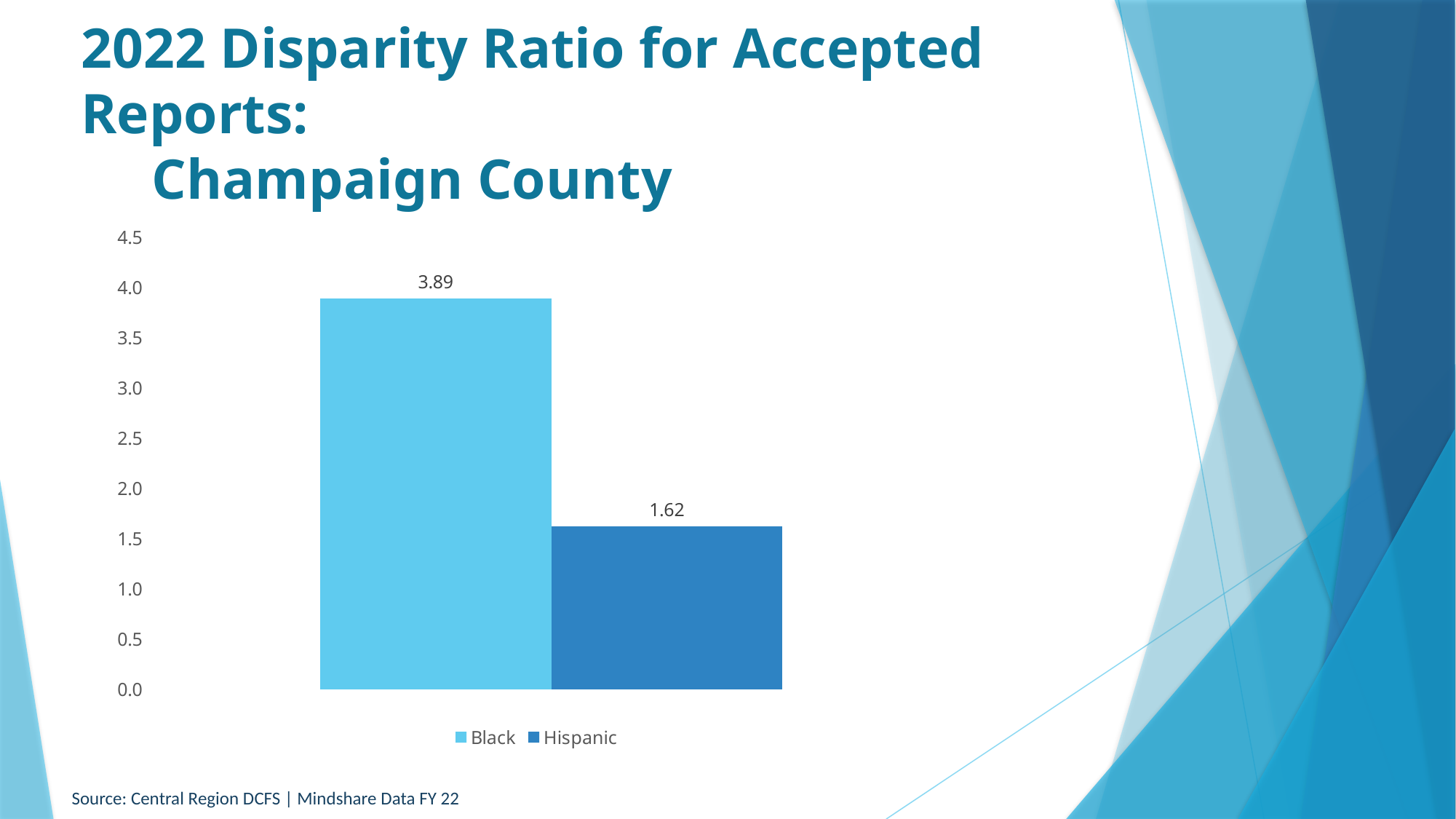
Which group has the lower disparity ratio? Hispanic Is the value for Hispanic greater or less than 2.0? less How many series does the legend list? 2 What is the disparity ratio for Black? 3.89 What is the disparity ratio for Hispanic? 1.62 Which group has the higher disparity ratio? Black What kind of chart is shown on the slide? bar chart Is the disparity ratio for Black larger or smaller than the ratio for Hispanic? larger Is the value for Black greater or less than 3.5? greater What is the highest value shown on the vertical axis? 4.5 What is the difference between the Black and Hispanic disparity ratios? 2.27 Which county does the chart's title refer to? Champaign County